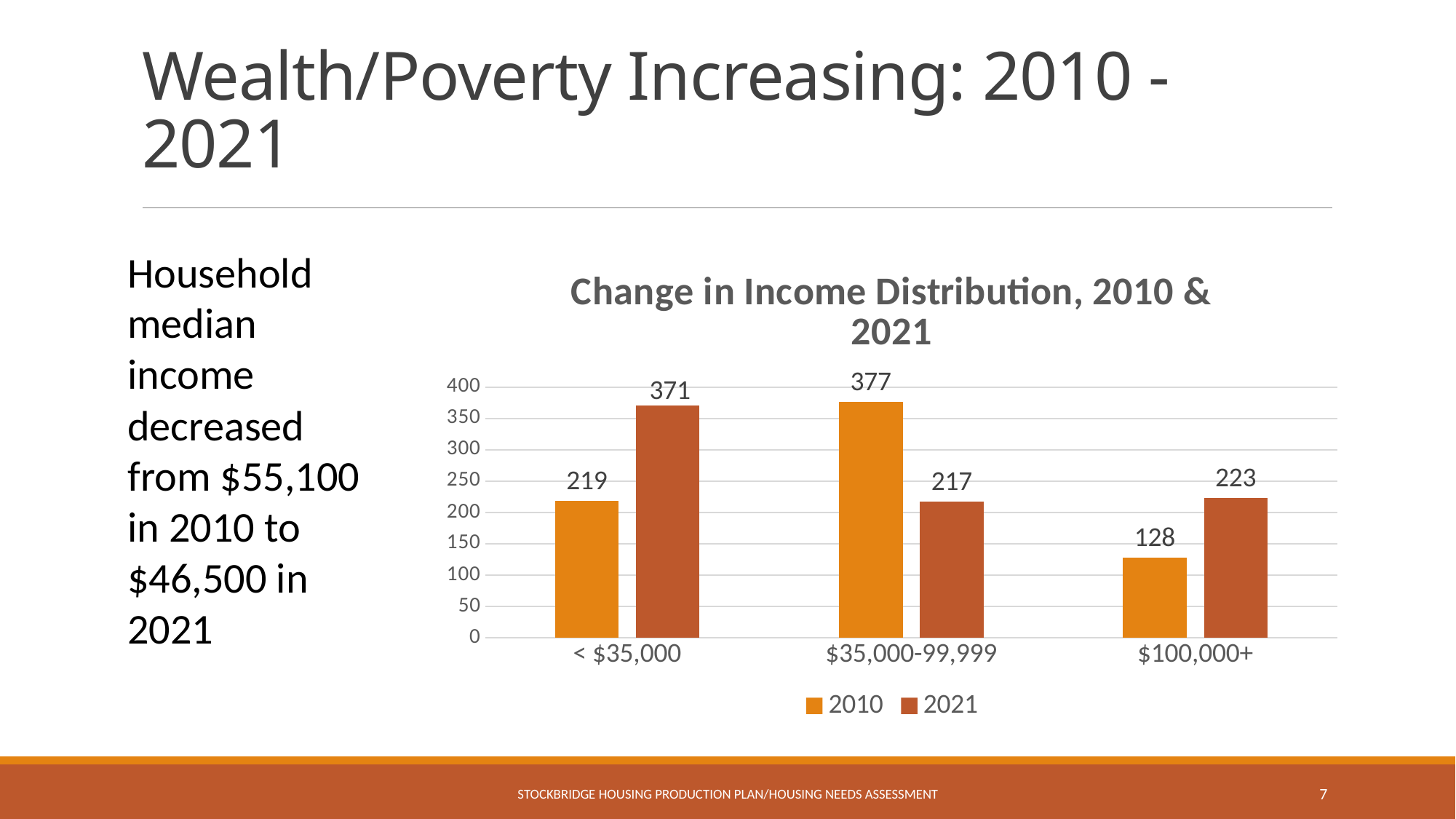
What is the difference between the 2021 and 2010 values for the < $35,000 category? 152 What type of chart is shown on the slide? Bar chart What is the 2010 value for the < $35,000 income category? 219 Which income category has the highest 2021 value? < $35,000 Which income category has the lowest 2010 value? $100,000+ What is the 2021 value for the $35,000-99,999 income category? 217 Which is larger for the $100,000+ category, the 2010 value or the 2021 value? 2021 How many income categories are shown on the x axis? 3 What is the 2021 value for the $100,000+ income category? 223 What is the difference between the 2010 and 2021 values for the $35,000-99,999 category? 160 How many series does the legend list? 2 Which income category has the highest 2010 value? $35,000-99,999